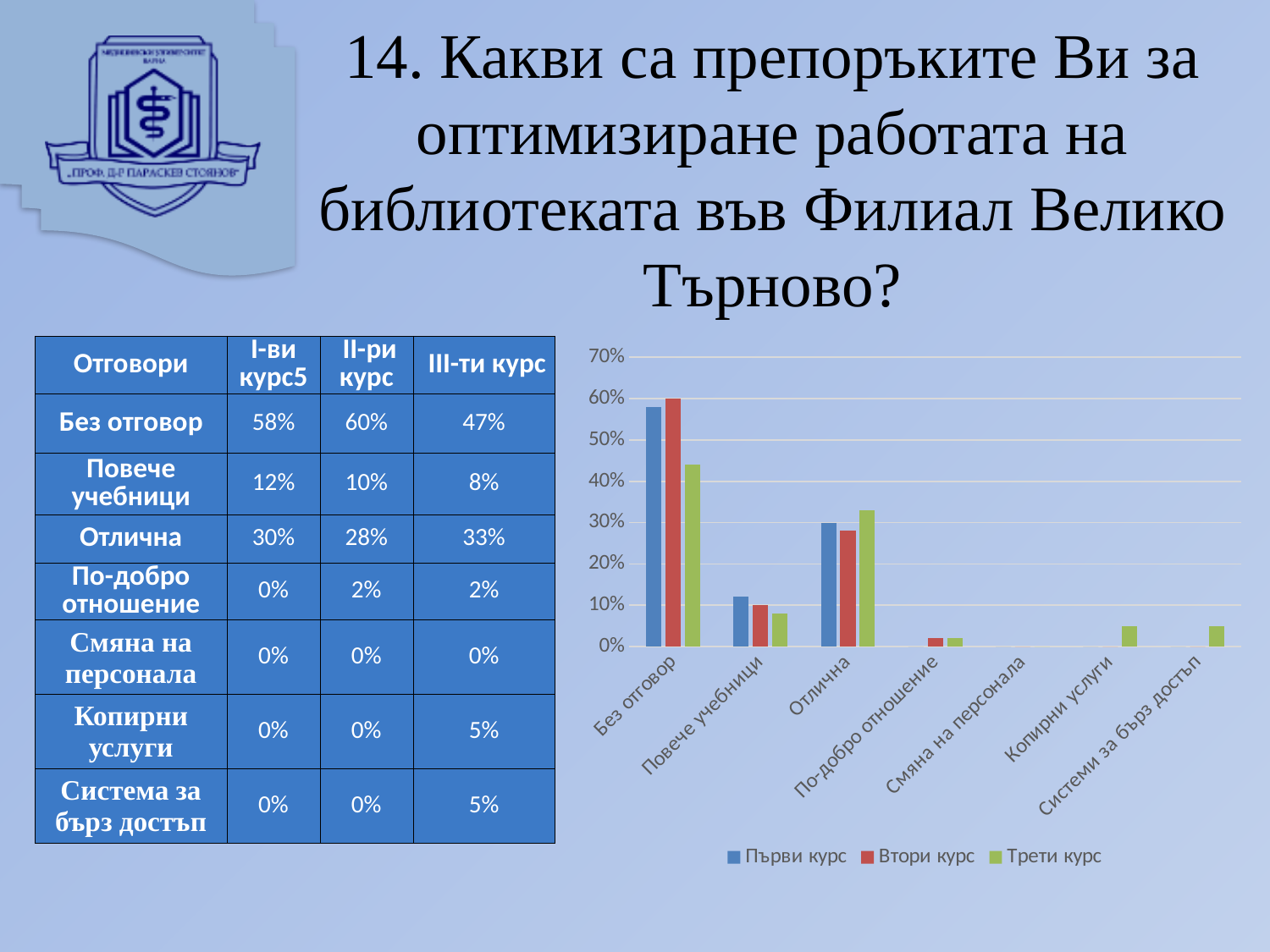
What kind of chart is shown on the slide? bar chart Is the value for Повече учебници for Първи курс greater or less than 20%? less Which category has the highest value for Първи курс in the chart? Без отговор According to the table, what is the difference between the Отлична values for III-ти курс and II-ри курс? 5% For Без отговор, which is larger: the value for Първи курс or for Трети курс? Първи курс For Отлична, which is larger: the value for Втори курс or for Трети курс? Трети курс How many series does the chart legend list? 3 According to the table, what is the value for Без отговор for II-ри курс? 60% Which series has the lowest value for Повече учебници? Трети курс How many categories are shown along the x axis of the chart? 7 What are the three entries in the chart legend? Първи курс, Втори курс, Трети курс Is the value for Без отговор for Първи курс greater or less than 50%? greater